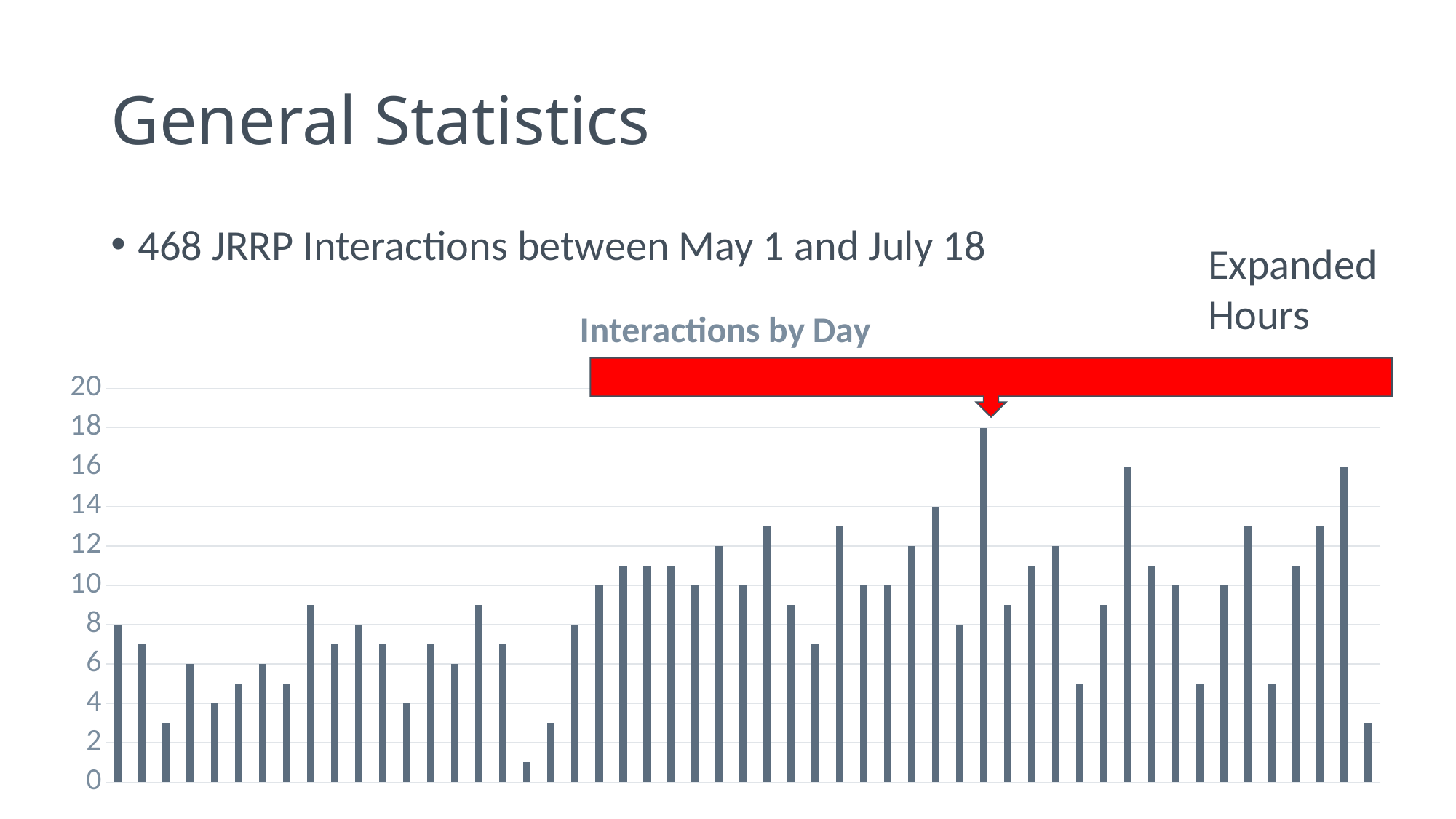
What kind of chart is shown on the slide? bar chart Is the first bar on the left of the chart greater or less than 6? greater Is the shortest bar in the chart greater or less than 2? less How many bars in the chart reach a value of 16? 2 Is the tallest bar in the chart greater or less than 16? greater What is the title of the chart? Interactions by Day Do the bar values generally rise or fall from left to right across the chart? rise What label is written above the red bar at the top right of the chart? Expanded Hours What is the value of the tallest bar in the Interactions by Day chart? 18 Which is larger: the tallest bar in the left half of the chart or the tallest bar in the right half? the right half